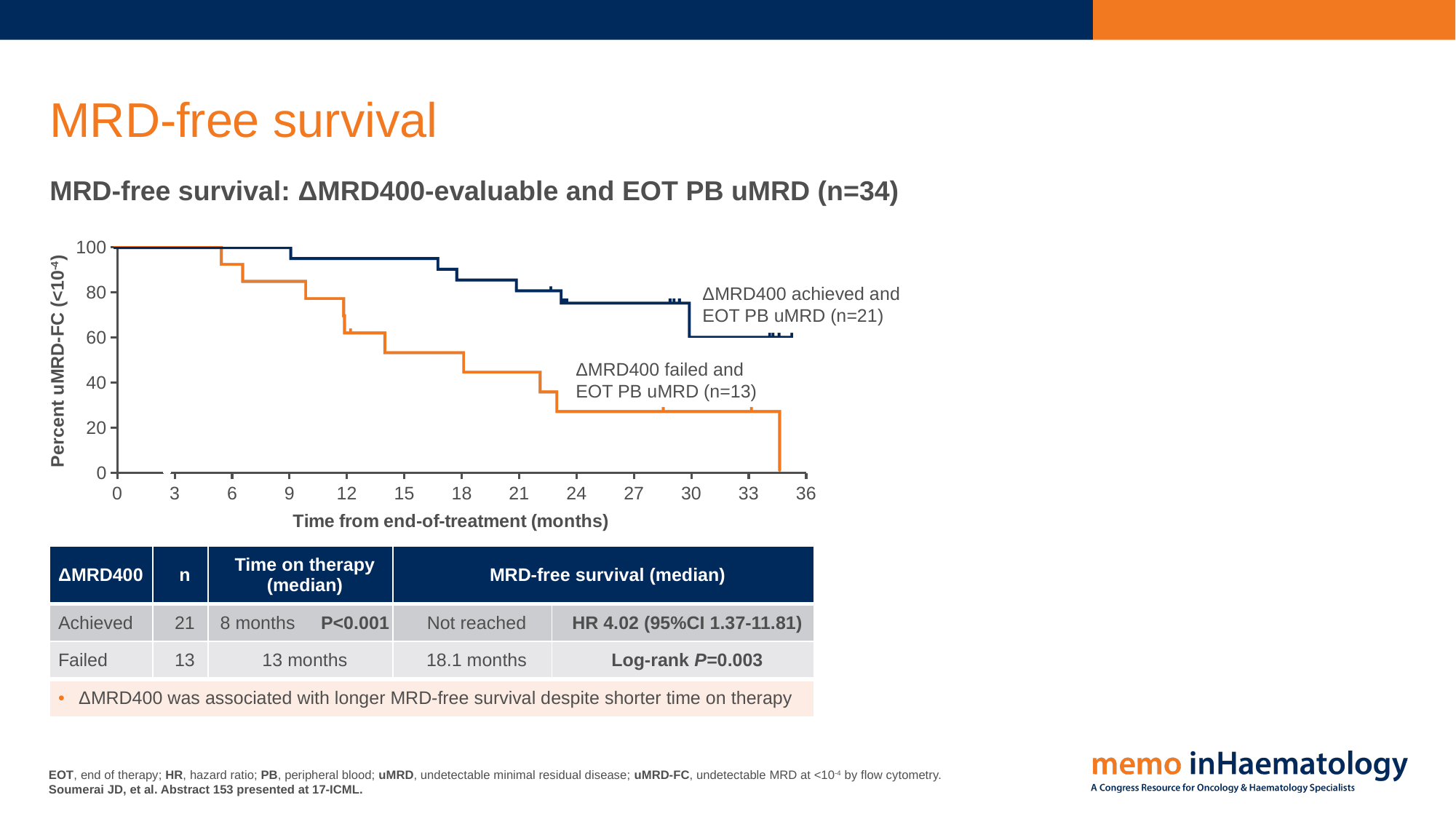
How many groups (curves) are plotted on the MRD-free survival chart? 2 At what value do both curves start at time 0? 100 Is the value of the ΔMRD400 achieved curve at 24 months greater or less than 60? greater Is the value of the ΔMRD400 failed curve at 27 months greater or less than 40? less Do the curves rise or fall as time from end-of-treatment increases? Fall What kind of chart is shown on the slide? Line chart (Kaplan-Meier survival curve) Is the value of the ΔMRD400 failed curve at 15 months greater or less than 40? greater What is the label of the y axis of the chart? Percent uMRD-FC (<10-4) What value does the ΔMRD400 failed curve reach at its final drop, around 34.5 months? 0 Which curve is higher at 24 months: ΔMRD400 achieved or ΔMRD400 failed? ΔMRD400 achieved What is the label of the x axis of the chart? Time from end-of-treatment (months)